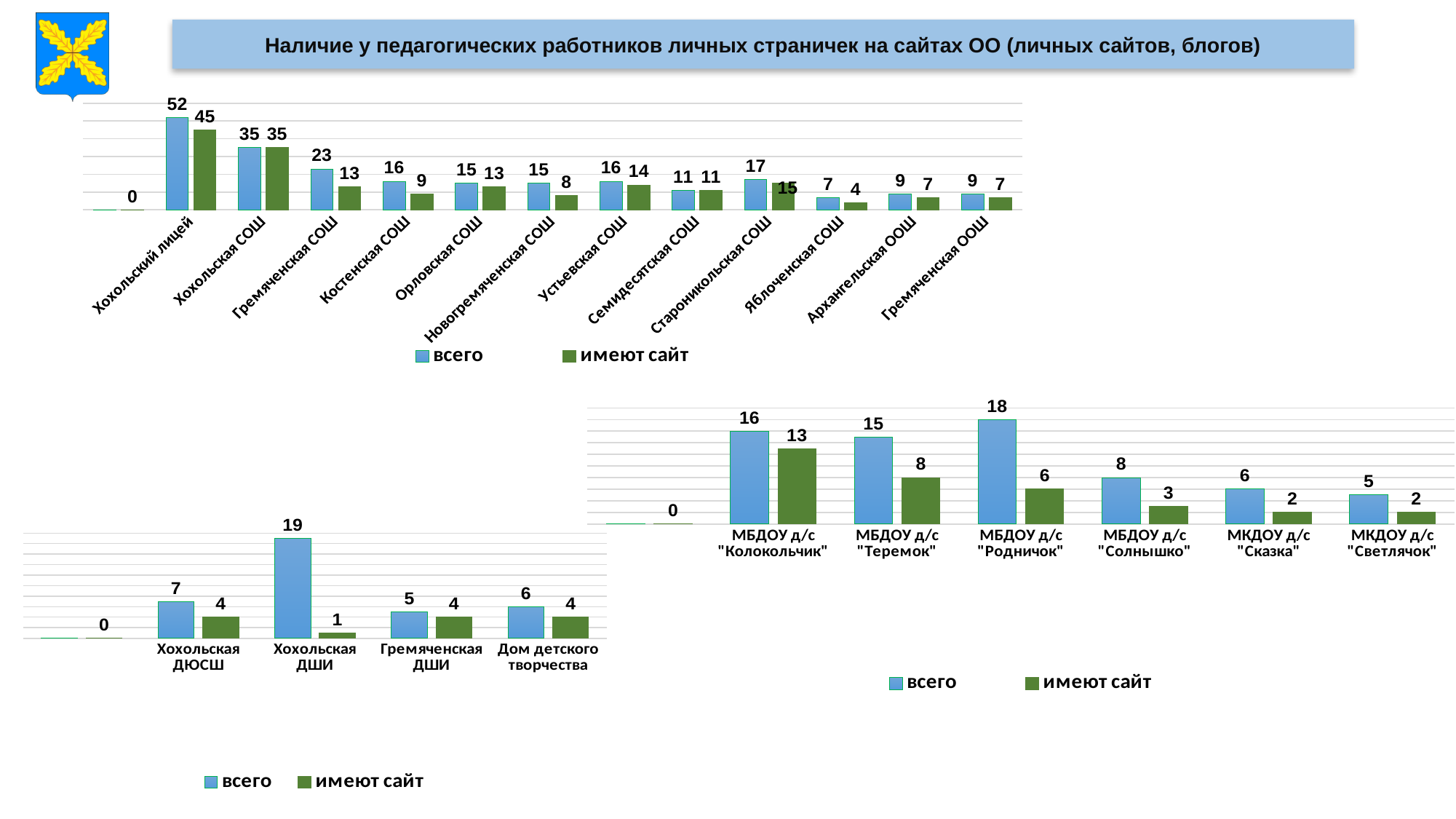
In the bottom-right chart, which kindergarten has the highest "всего" value? МБДОУ д/с "Родничок" In the top chart, which is larger for Устьевская СОШ: "всего" or "имеют сайт"? всего In the top chart, which school has the highest "всего" value? Хохольский лицей In the top chart, what is the value of "всего" for Хохольский лицей? 52 How many series does the legend of the top chart list? 2 In the bottom-right chart, what is the difference between "всего" and "имеют сайт" for МБДОУ д/с "Теремок"? 7 In the top chart, what is the value of "имеют сайт" for Гремяченская СОШ? 13 In the bottom-right chart, what is the "имеют сайт" value for МБДОУ д/с "Колокольчик"? 13 What type of chart is the bottom-right chart? bar chart In the top chart, what is the difference between "всего" and "имеют сайт" for Костенская СОШ? 7 In the bottom-left chart, what is the "всего" value for Хохольская ДШИ? 19 In the bottom-left chart, which category has the lowest "имеют сайт" value among the labeled categories? Хохольская ДШИ